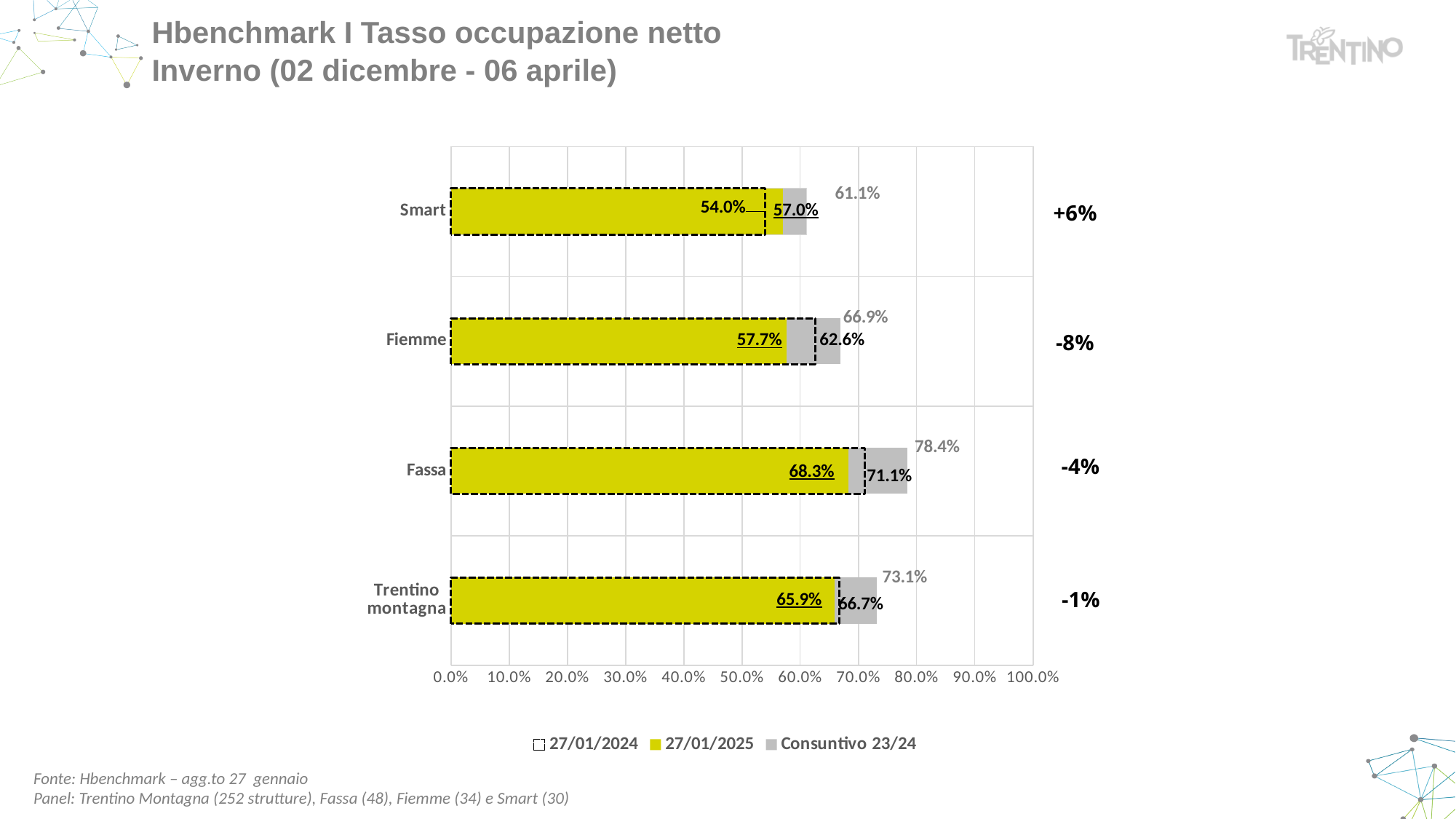
What is the 27/01/2025 value for Trentino montagna? 65.9% Which category has the highest Consuntivo 23/24 value? Fassa How many series does the legend list? 3 What is the 27/01/2024 value for Fiemme? 62.6% What kind of chart is shown on the slide? Bar chart How many categories are shown on the chart? 4 What is the value for Smart in the 27/01/2025 series? 57.0% What percentage change is shown to the right of the Fiemme bar? -8% What is the difference between the Consuntivo 23/24 value and the 27/01/2025 value for Fassa? 10.1 percentage points What is the Consuntivo 23/24 value for Fassa? 78.4% Which category has the lowest 27/01/2025 value? Smart Which is larger: the 27/01/2025 value for Fiemme or for Smart? Fiemme